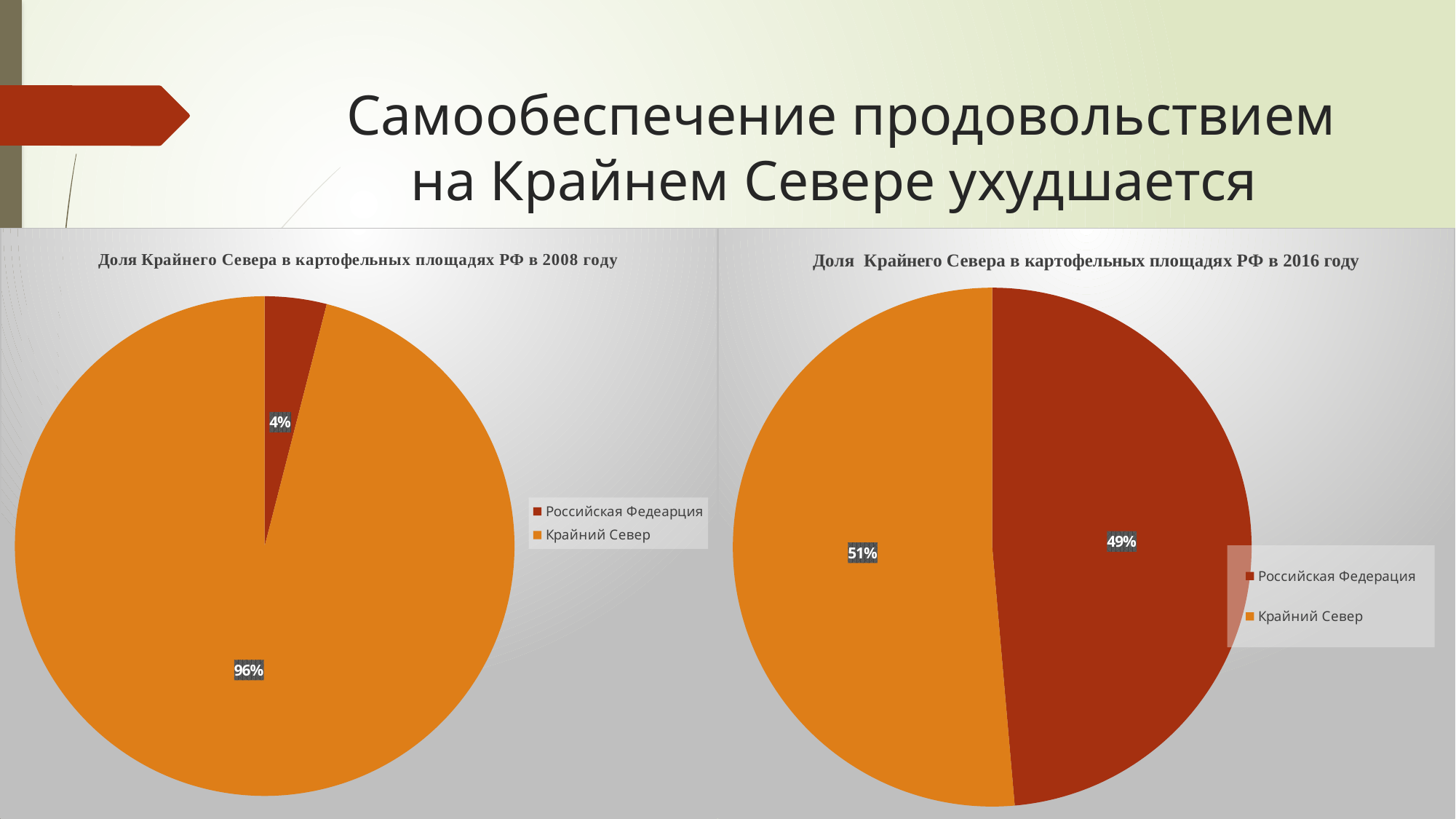
How many slices does the right chart (2016) have? 2 In the left chart (2008), what share is labelled for Российская Федеарция? 4% Which is larger: the Российская Федеарция share in the left chart (2008) or the Российская Федерация share in the right chart (2016)? The right chart (2016), 49% In the right chart (2016), what is the difference between the Крайний Север share and the Российская Федерация share? 2% In the right chart (2016), what share is labelled for Российская Федерация? 49% In the right chart (2016), what share is labelled for Крайний Север? 51% How many entries does the legend of the left chart (2008) list? 2 What kind of chart is the left chart, 'Доля Крайнего Севера в картофельных площадях РФ в 2008 году'? Pie chart In the left chart (2008), which slice is the smallest? Российская Федеарция In the left chart (2008), what is the difference between the Крайний Север share and the Российская Федеарция share? 92% In the left chart (2008), which slice is the largest? Крайний Север